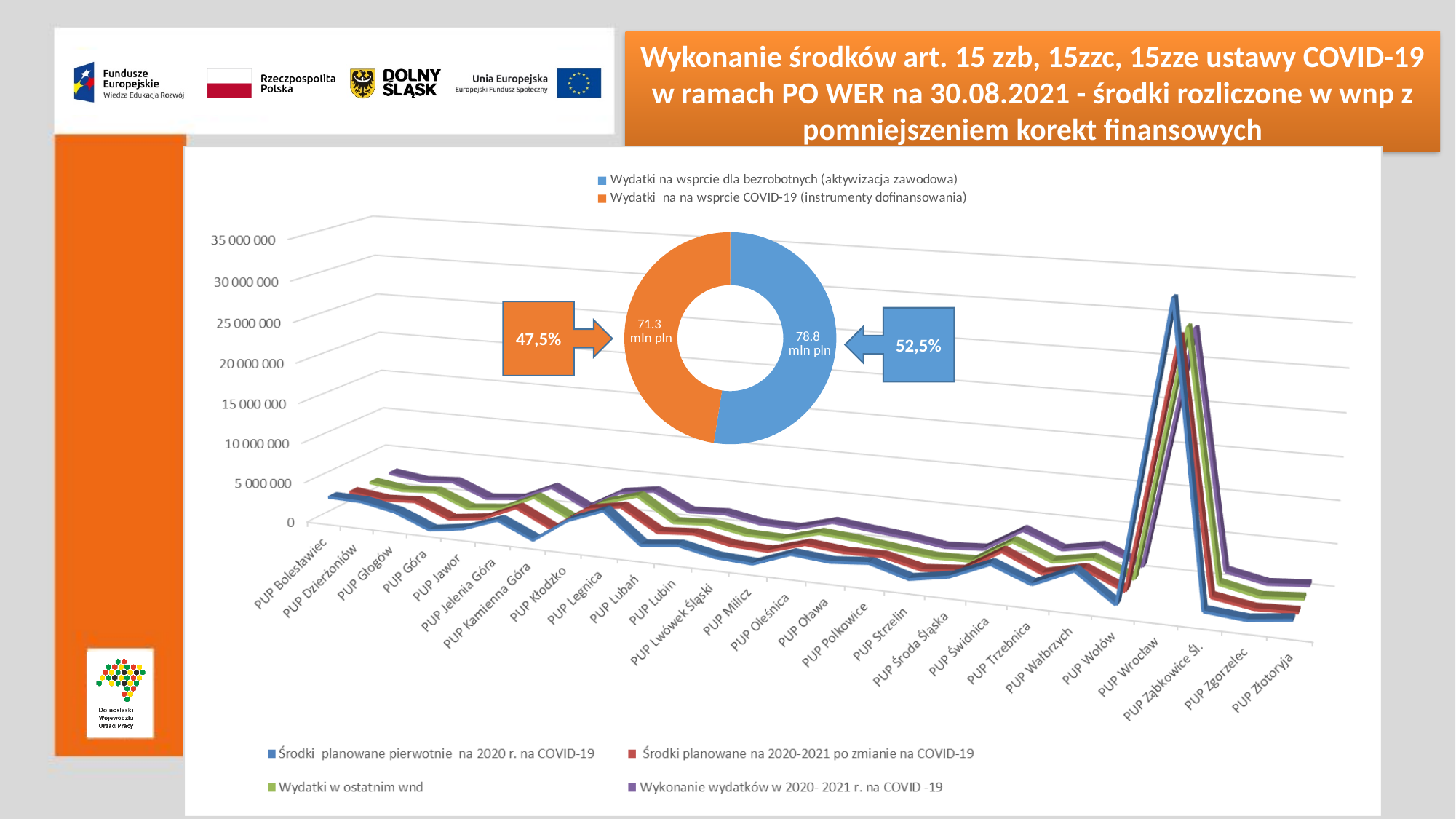
On the donut chart, what value is shown for the blue slice (Wydatki na wsprcie dla bezrobotnych)? 78.8 mln pln On the donut chart, which slice is larger: the blue one or the orange one? the blue one What kind of chart is the large chart with PUP offices along the x axis? line chart How many series does the legend of the line chart with PUP offices list? 4 On the line chart with PUP offices, which PUP has the highest values? PUP Wrocław How many series does the legend of the donut chart list? 2 On the line chart with PUP offices, how many PUP categories are shown on the x axis? 26 On the donut chart, what percentage share is given for the orange slice (Wydatki na wsprcie COVID-19)? 47,5% On the donut chart, what is the difference in mln pln between the blue slice and the orange slice? 7.5 mln pln On the donut chart, what value is shown for the orange slice (Wydatki na wsprcie COVID-19)? 71.3 mln pln What kind of chart is the chart in the centre of the slide showing 78.8 mln pln and 71.3 mln pln? donut (pie) chart On the donut chart, what percentage share is given for the blue slice (Wydatki na wsprcie dla bezrobotnych)? 52,5%